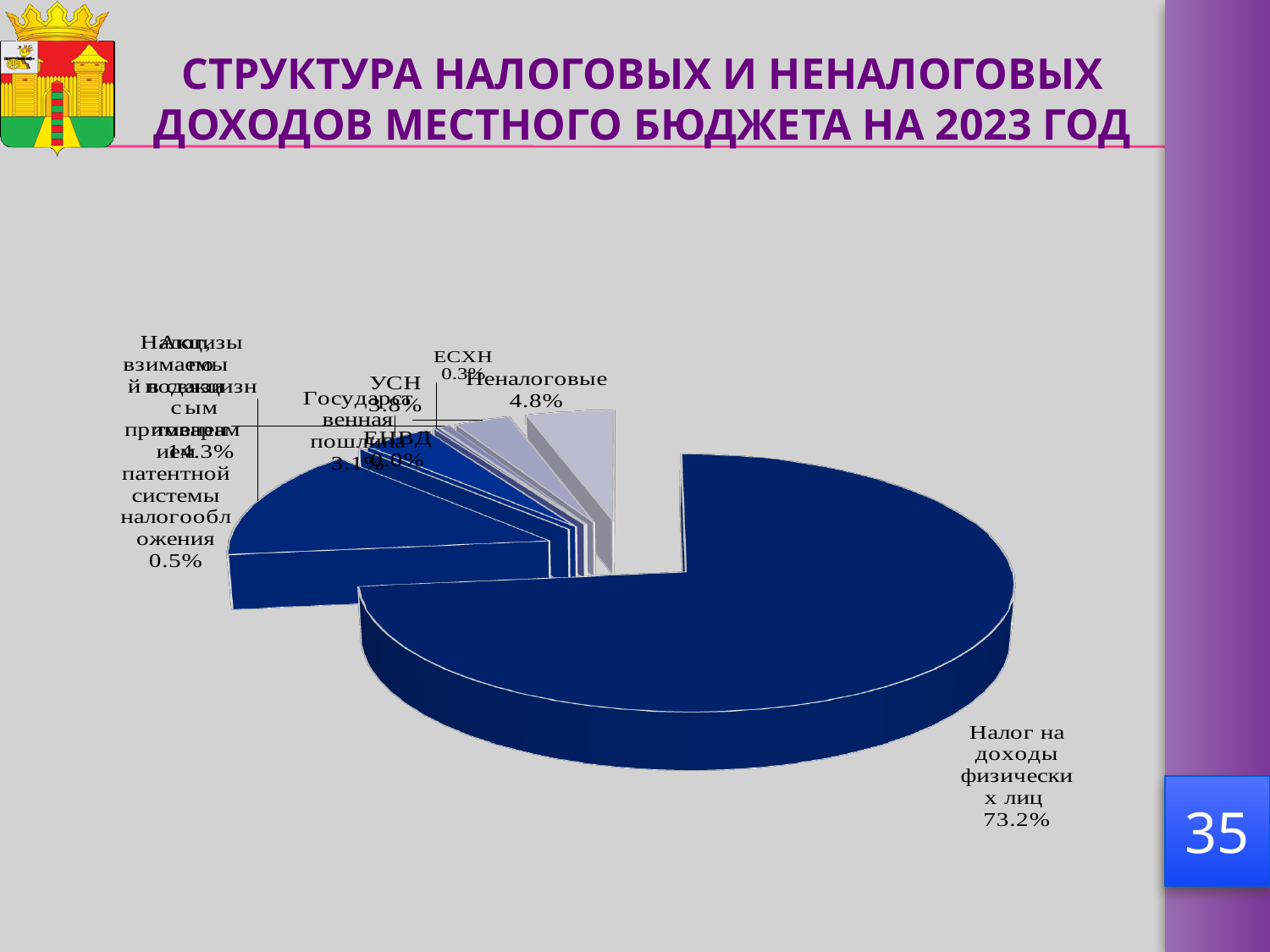
What is the value shown for ЕСХН? 0.3% What is the title of the slide containing the chart? СТРУКТУРА НАЛОГОВЫХ И НЕНАЛОГОВЫХ ДОХОДОВ МЕСТНОГО БЮДЖЕТА НА 2023 ГОД What is the value shown for Государственная пошлина? 3.1% What is the difference between the shares of Налог на доходы физических лиц and Неналоговые? 68.4% Which category has the smallest share of the pie? ЕНВД Which category has the largest share of the pie? Налог на доходы физических лиц What is the value shown for УСН? 3.8% What is the value shown for ЕНВД? 0.0% What kind of chart is shown on the slide? pie chart Which is larger, the share for УСН or the share for Государственная пошлина? УСН What share of the pie does Налог на доходы физических лиц have? 73.2% What is the value shown for Неналоговые? 4.8%